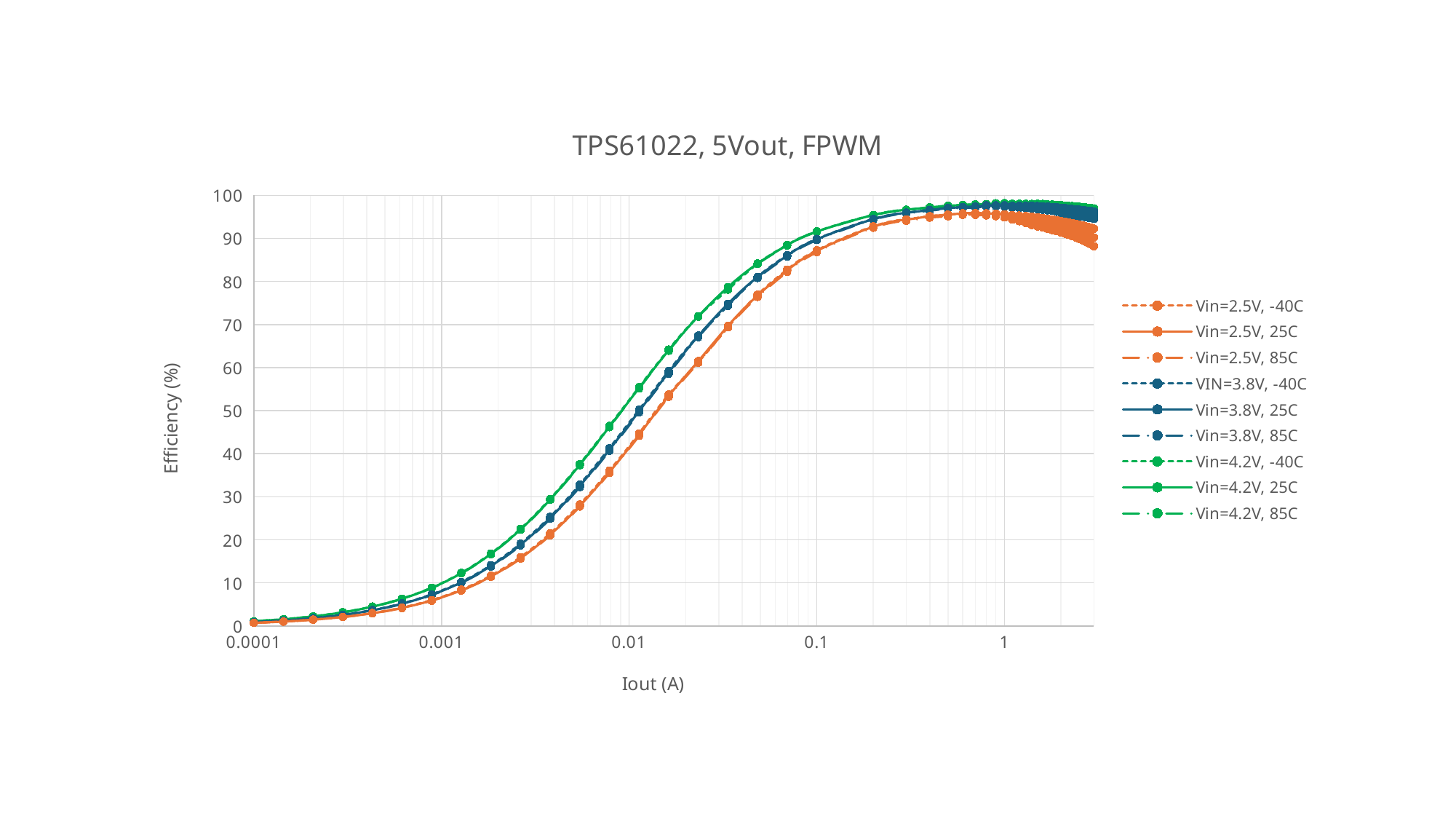
At Iout = 0.01 A, is the efficiency for Vin=2.5V, 25C greater or less than 50? less Which input voltage group of curves has the lowest efficiency at the highest Iout values? Vin=2.5V At Iout = 0.01 A, is the efficiency for Vin=4.2V, 25C greater or less than 40? greater What is the title of the chart? TPS61022, 5Vout, FPWM Does efficiency rise or fall as Iout increases from 0.0001 A to 0.1 A? Rise Which input voltage group of curves reaches the highest efficiency on the chart? Vin=4.2V At Iout = 0.01 A, which has the higher efficiency, Vin=4.2V, 25C or Vin=2.5V, 25C? Vin=4.2V, 25C At Iout = 0.1 A, is the efficiency for Vin=2.5V, 25C greater or less than 80? greater What is the label of the y axis? Efficiency (%) What kind of chart is shown on the slide? Line chart How many series does the legend list? 9